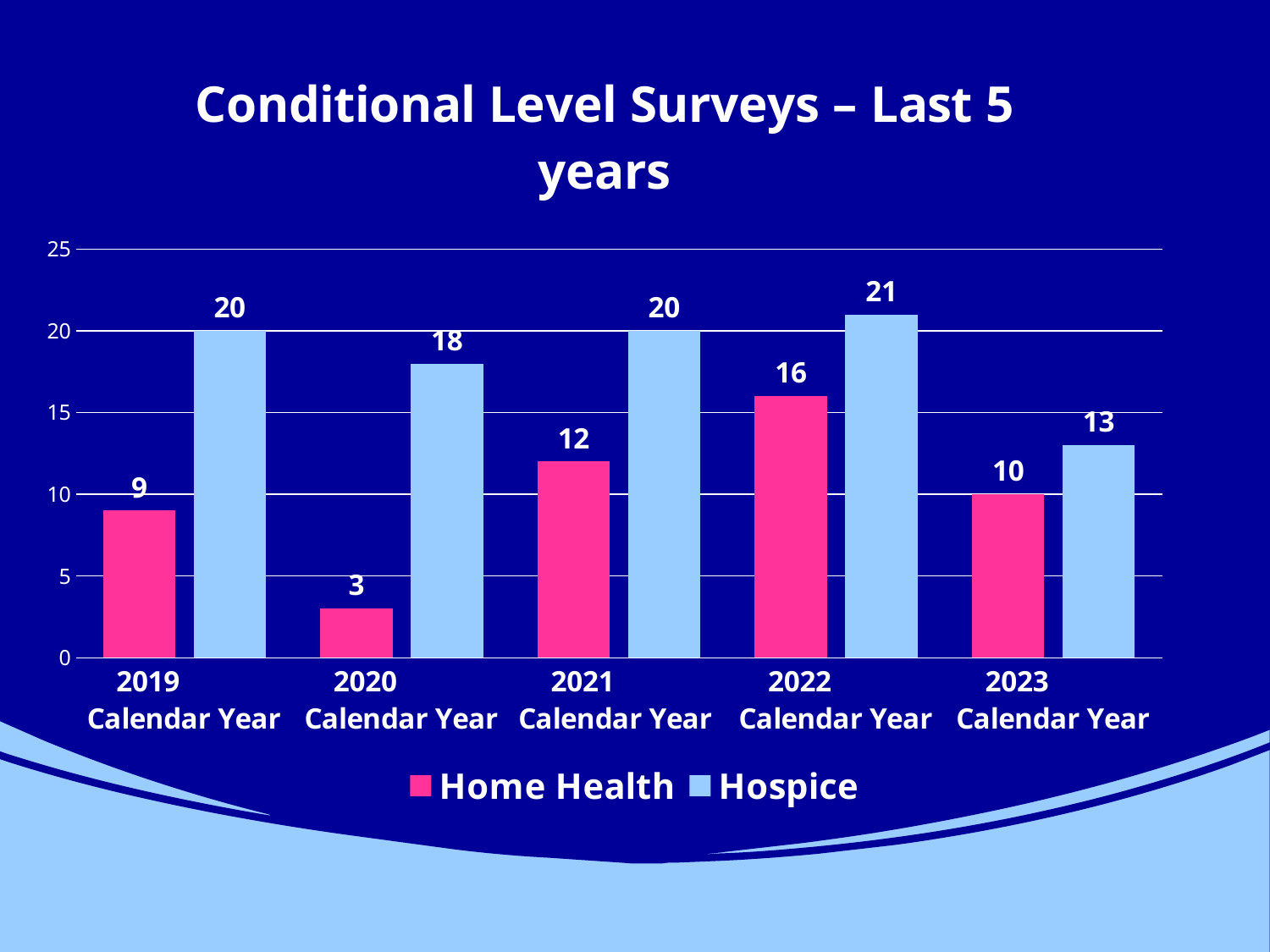
Which calendar year has the lowest Home Health value? 2020 Calendar Year Which calendar year has the highest Hospice value? 2022 Calendar Year What is the title of the chart? Conditional Level Surveys – Last 5 years What is the Home Health value for 2023 Calendar Year? 10 Which is larger in 2022 Calendar Year, Home Health or Hospice? Hospice How many series does the legend list? 2 How many calendar years are shown on the x axis? 5 What is the difference between the Hospice and Home Health values for 2019 Calendar Year? 11 What kind of chart is shown on the slide? Bar chart What is the Home Health value for 2020 Calendar Year? 3 What is the Hospice value for 2022 Calendar Year? 21 Which colour represents Home Health in the legend? Pink